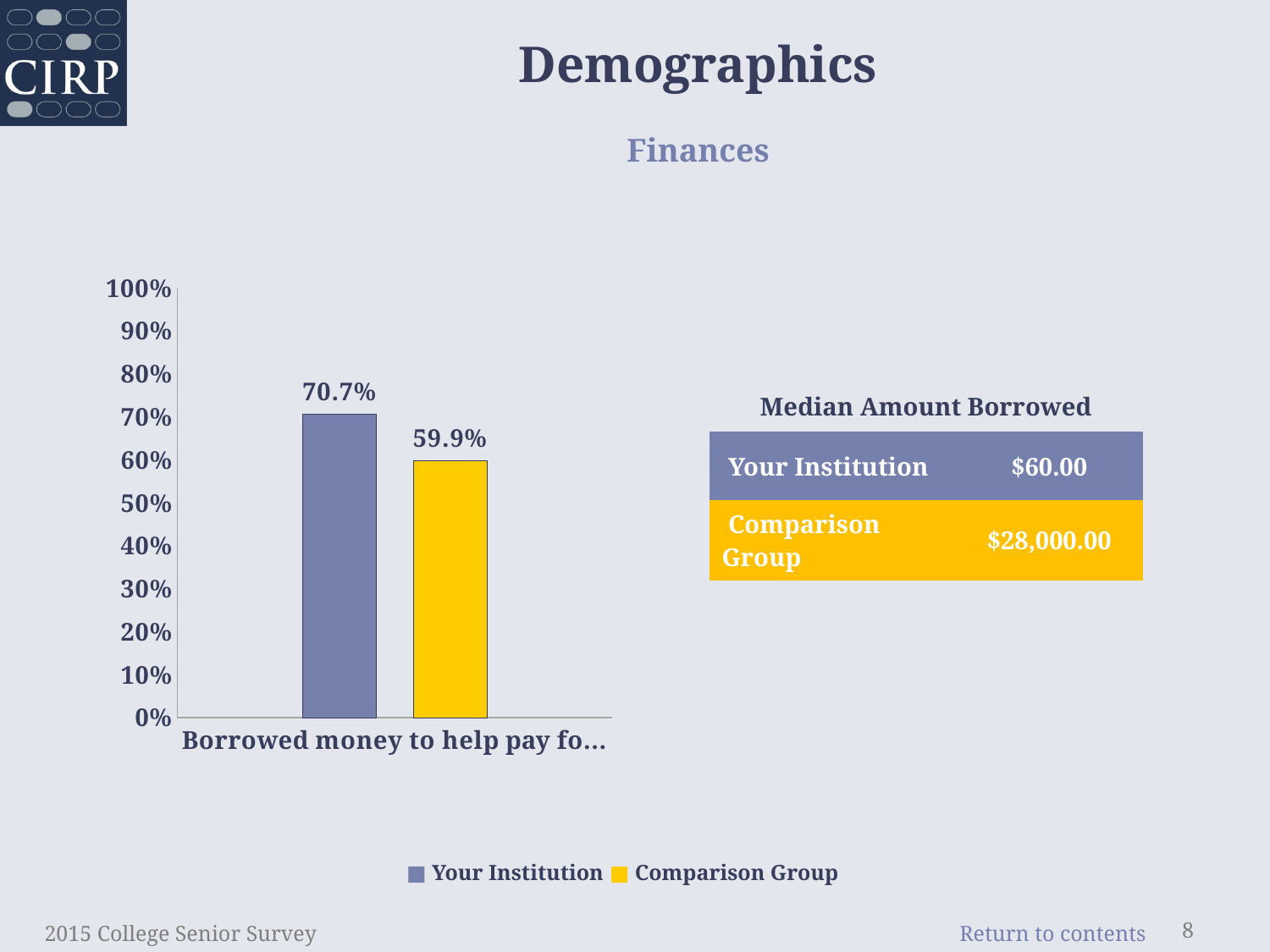
What kind of chart is shown on the slide? bar chart How many series does the legend of the bar chart list? 2 What is the value for Comparison Group in the bar chart? 59.9% Is the value for Comparison Group in the bar chart greater or less than 60%? less Which series has the higher value in the bar chart, Your Institution or Comparison Group? Your Institution Is the value for Your Institution in the bar chart greater or less than 70%? greater How many bars are plotted in the bar chart? 2 What is the highest value shown on the y axis of the bar chart? 100% Which colour represents Comparison Group in the bar chart legend? yellow What is the value for Your Institution in the bar chart? 70.7% What is the difference between the Your Institution and Comparison Group values in the bar chart? 10.8%